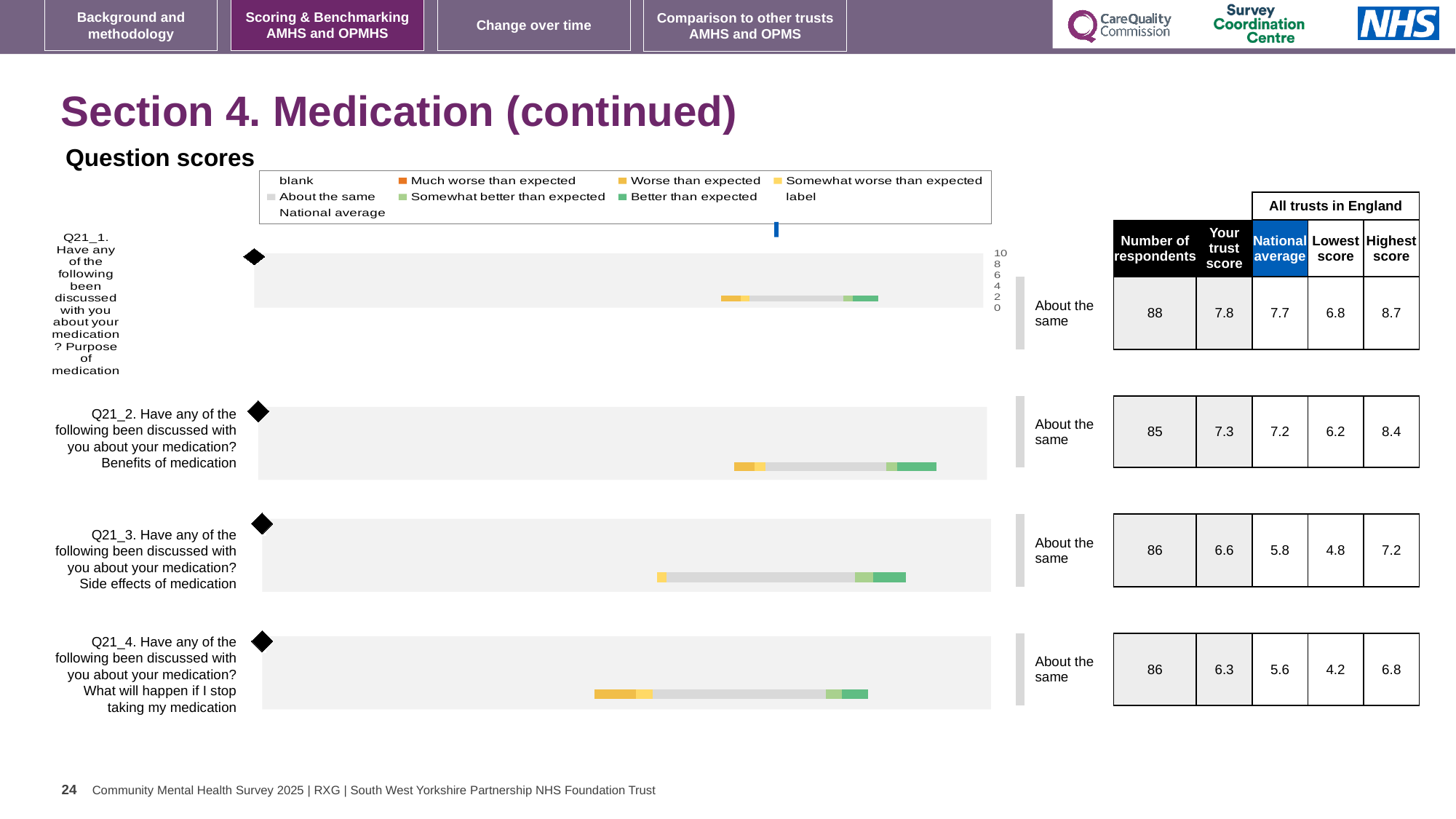
How many entries does the legend above the charts list? 9 How many question charts (Q21_1 to Q21_4) are shown on the slide? 4 For the Q21_1 chart (Purpose of medication), what is the trust score shown in the table? 7.8 For the Q21_3 chart, what is the difference between the trust score and the national average? 0.8 Which question chart has the lowest trust score? Q21_4 (What will happen if I stop taking my medication) What benchmark label is shown next to the Q21_4 chart? About the same For the Q21_4 chart (What will happen if I stop taking my medication), how many respondents are there? 86 For the Q21_3 chart (Side effects of medication), what is the lowest score among all trusts in England? 4.8 Which question chart has the highest trust score? Q21_1 (Purpose of medication) What kind of chart is used for the question scores on this slide? bar chart For the Q21_2 chart (Benefits of medication), what is the national average? 7.2 For the Q21_2 chart, which is larger: the trust score or the national average? the trust score